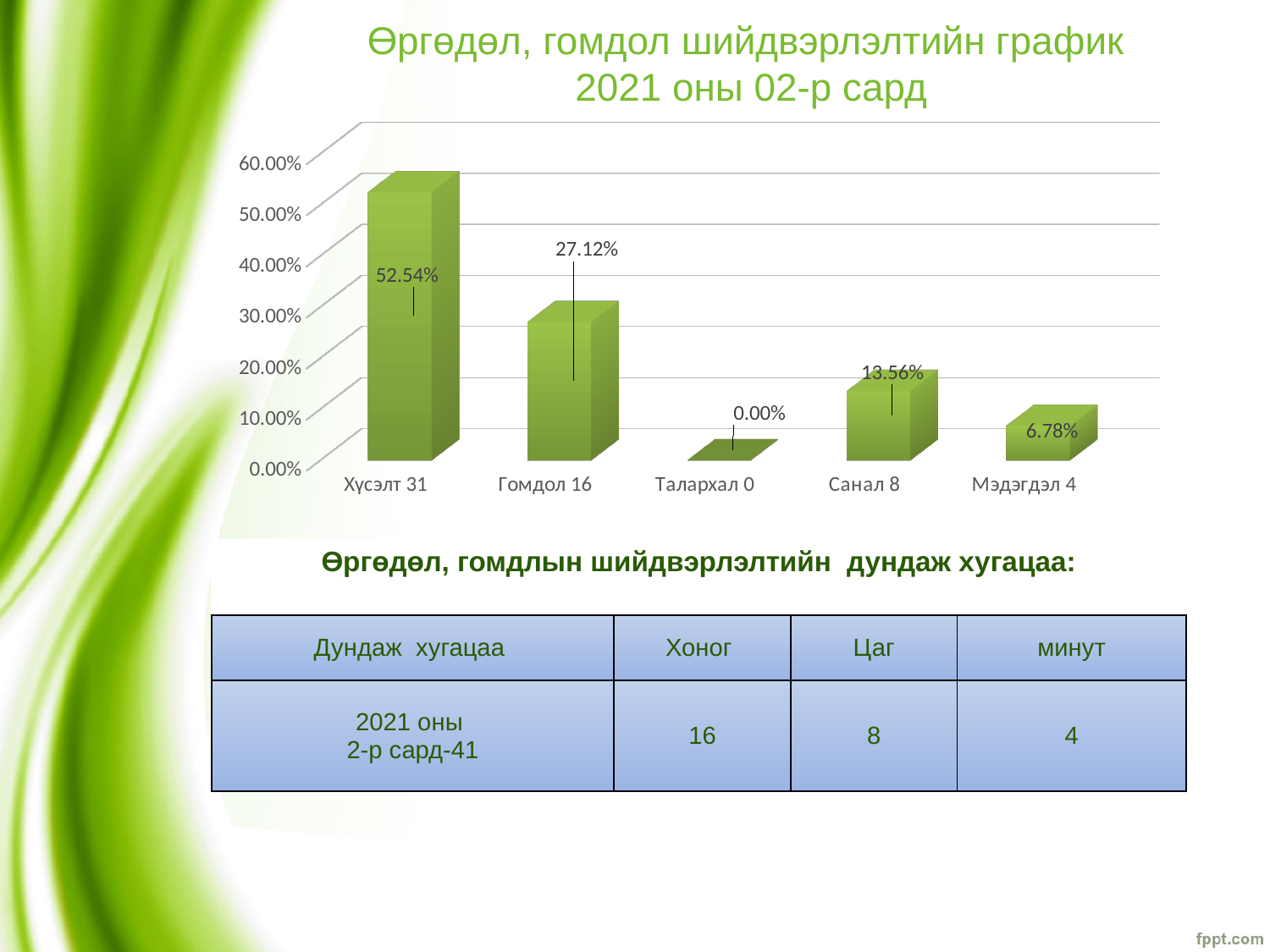
How many categories are shown on the x axis? 5 What is the title of the chart? Өргөдөл, гомдол шийдвэрлэлтийн график 2021 оны 02-р сард Which category has the highest value? Хүсэлт 31 Which category has the lowest value? Талархал 0 What is the value for Мэдэгдэл 4? 6.78% What is the value for Санал 8? 13.56% What is the value for Гомдол 16? 27.12% What kind of chart is shown on the slide? bar chart Is the value for Гомдол 16 greater or less than 30.00%? less What is the value for Хүсэлт 31? 52.54% Which is larger, the value for Санал 8 or the value for Мэдэгдэл 4? Санал 8 What is the difference between the values for Хүсэлт 31 and Гомдол 16? 25.42%